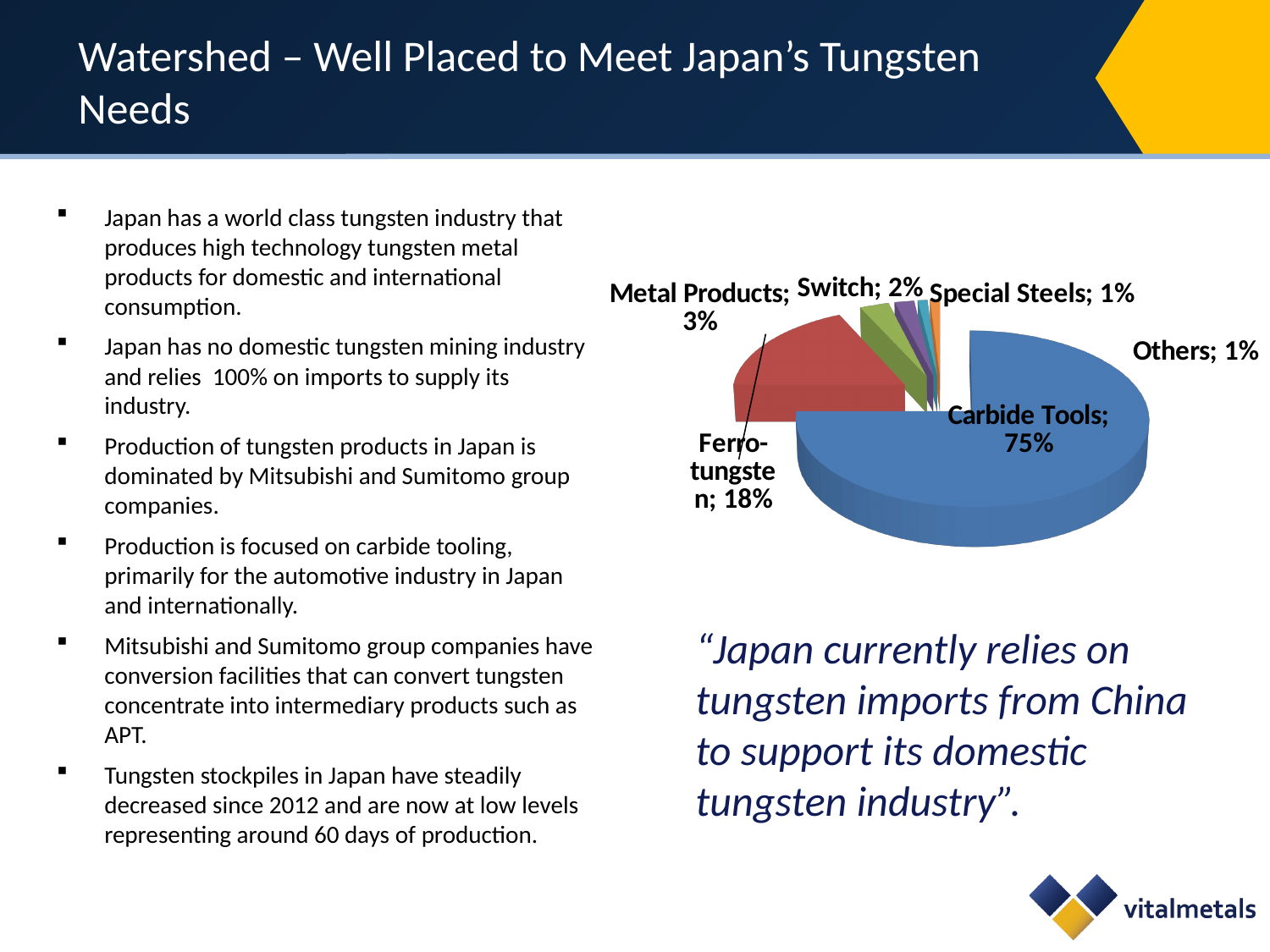
What kind of chart is shown on the slide? Pie chart What is the difference between the Carbide Tools share and the Ferro-tungsten share? 57% Which category has the largest slice of the pie? Carbide Tools What is the combined share of Carbide Tools and Ferro-tungsten? 93% What is the value shown for Metal Products? 3% What is the value shown for Special Steels? 1% Which is larger, the share for Metal Products or the share for Switch? Metal Products What colour is the Carbide Tools slice? Blue What is the value shown for Switch? 2% What share of the pie does Carbide Tools account for? 75% How many slices does the pie chart have? 6 What is the value shown for Ferro-tungsten? 18%